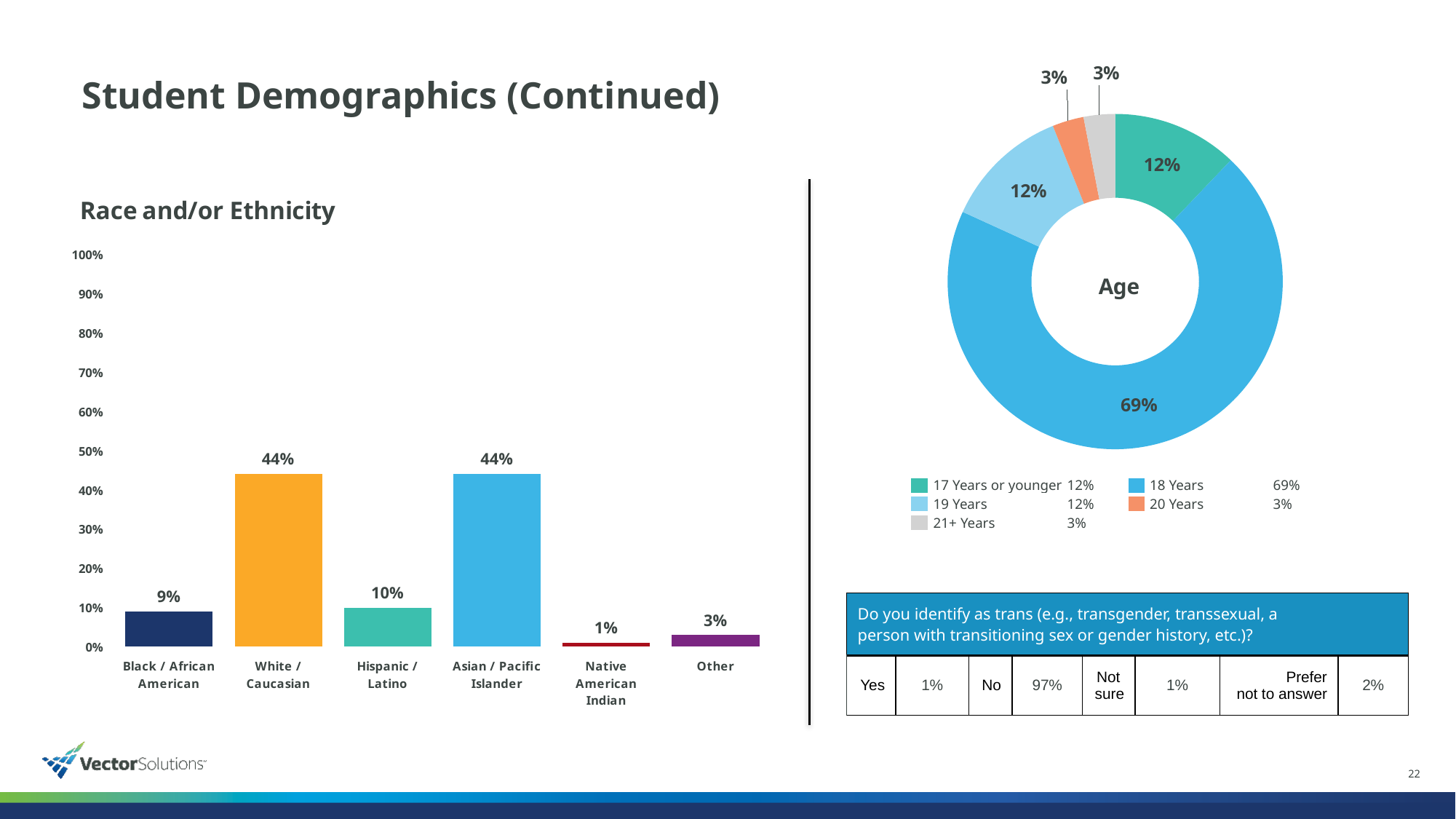
How many categories are shown in the Race and/or Ethnicity chart? 6 What kind of chart is the Age chart? Doughnut chart In the Race and/or Ethnicity chart, what is the value for Black / African American? 9% In the Race and/or Ethnicity chart, which category has the lowest value? Native American Indian What kind of chart is the Race and/or Ethnicity chart? Bar chart In the Age chart, what share is 18 Years? 69% In the Race and/or Ethnicity chart, what is the difference between White / Caucasian and Hispanic / Latino? 34% In the Race and/or Ethnicity chart, what is the value for Hispanic / Latino? 10% In the Race and/or Ethnicity chart, which is larger: Black / African American or Other? Black / African American In the Age chart, which age group has the largest share? 18 Years How many entries does the legend of the Age chart list? 5 In the Age chart, what is the value for 21+ Years? 3%